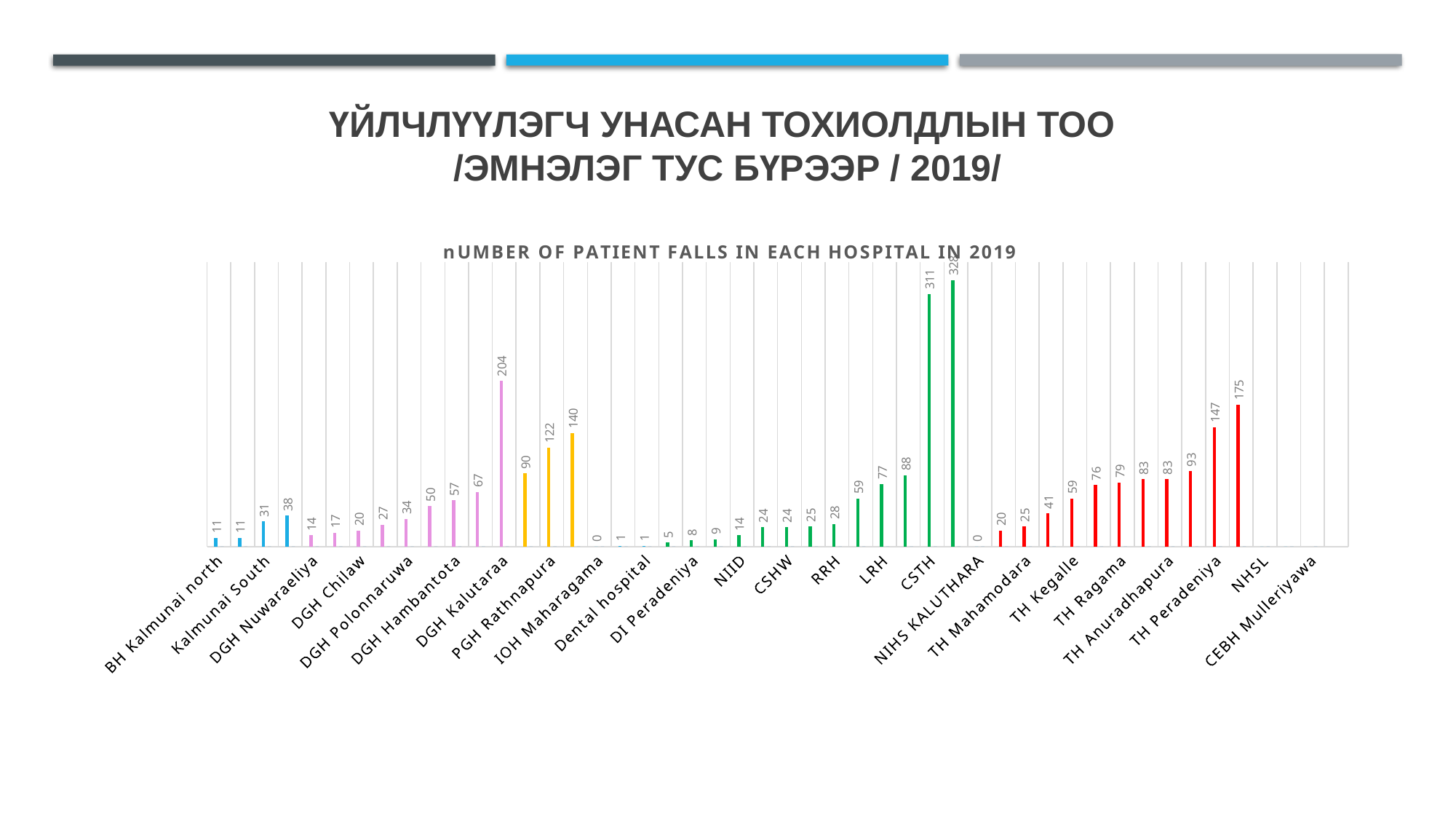
What colour are the bars for the TH hospitals (e.g. TH Kegalle, TH Ragama, TH Peradeniya)? red What is the highest value shown by any bar in the chart? 328 What is the value for BH Kalmunai north? 11 What is the value for DGH Kalutaraa? 204 What is the lowest value shown by any bar in the chart? 0 What is the title of the chart? nUMBER OF PATIENT FALLS IN EACH HOSPITAL IN 2019 Which has a larger value, DGH Kalutaraa or CSTH? CSTH What is the value for CSTH? 311 What is the difference between the two tallest bars in the chart (328 and 311)? 17 What is the value for TH Peradeniya? 147 What kind of chart is shown on the slide? bar chart What is the difference between the values for CSTH and DGH Kalutaraa? 107